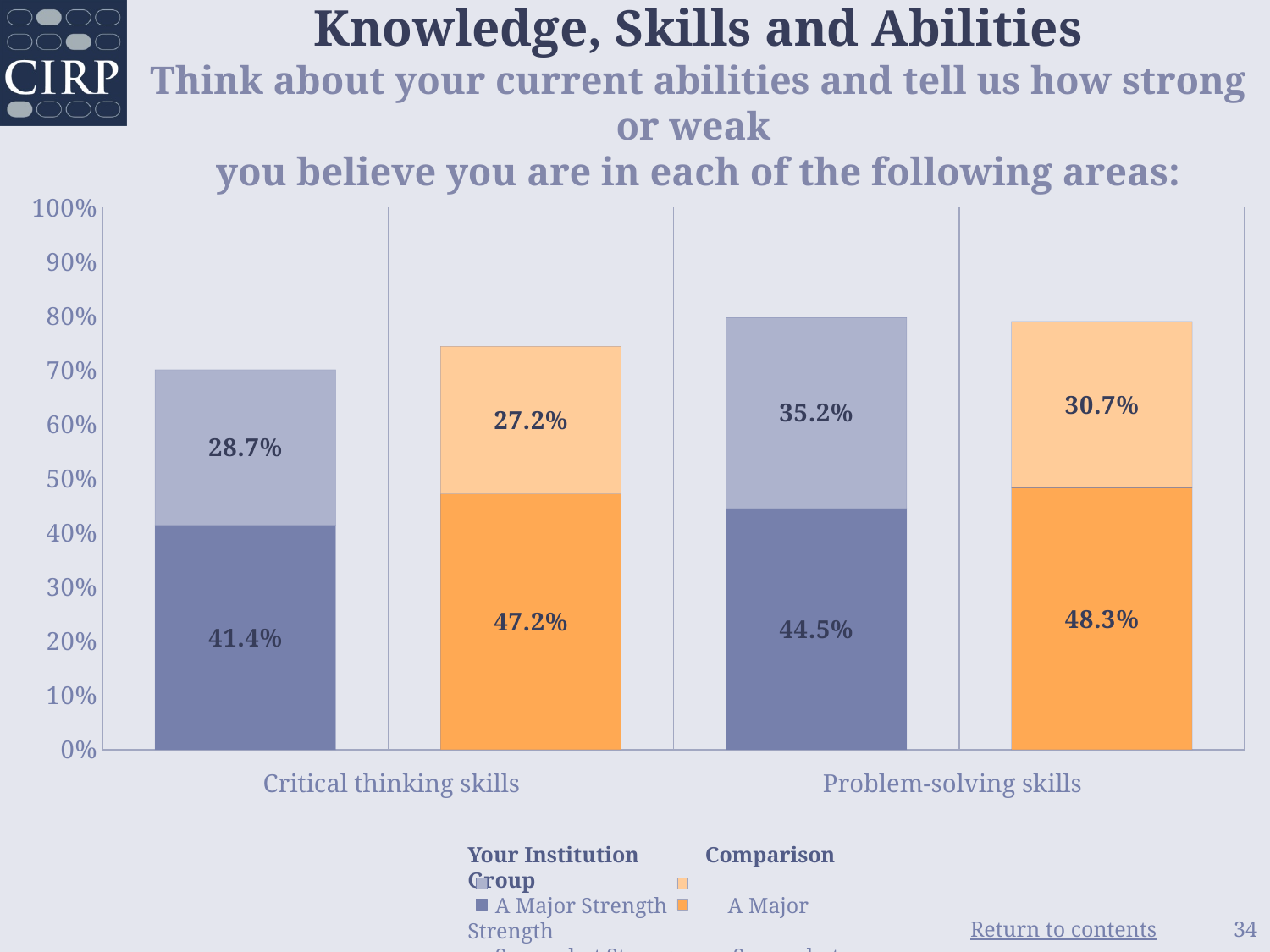
For critical thinking skills, how much higher is the Comparison Group's 'A Major Strength' value than Your Institution's? 5.8 percentage points What percentage of the Comparison Group rated problem-solving skills as 'A Major Strength'? 48.3% What value is shown in the upper (lighter) segment of the Comparison Group bar for critical thinking skills? 27.2% What is the total height of the Comparison Group stacked bar for problem-solving skills? 79.0% Is the total height of the Your Institution bar for problem-solving skills greater or less than 70%? greater What is the total height of the Your Institution stacked bar for critical thinking skills? 70.1% How many skill areas are shown on the x axis of the chart? 2 What value is shown in the upper (lighter) segment of the Your Institution bar for problem-solving skills? 35.2% Which bar has the highest 'A Major Strength' value on the chart? Comparison Group, problem-solving skills (48.3%) What percentage of Your Institution respondents rated critical thinking skills as 'A Major Strength'? 41.4% For Your Institution, is the 'A Major Strength' value larger for critical thinking skills or problem-solving skills? Problem-solving skills What type of chart is shown on the slide? Stacked bar chart